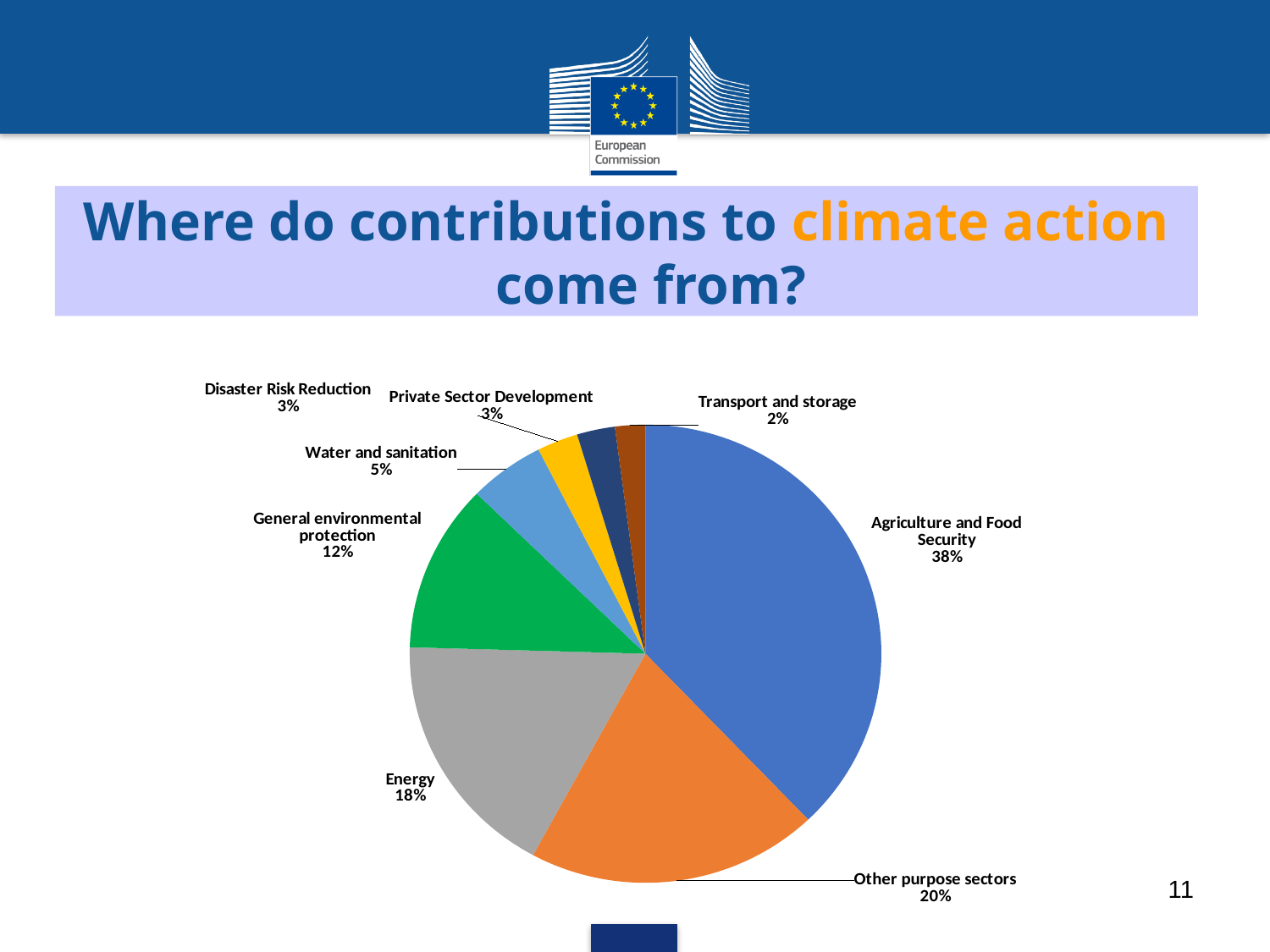
What percentage is shown for Water and sanitation? 5% Which sector has the smallest slice of the pie? Transport and storage What percentage is shown for General environmental protection? 12% What share of contributions to climate action comes from Agriculture and Food Security? 38% How many sectors are shown in the pie chart? 8 Which is larger, the share for Energy or the share for General environmental protection? Energy What type of chart is shown on the slide? Pie chart Which sector has the largest slice of the pie? Agriculture and Food Security What share of the pie does Energy account for? 18% What is the difference in percentage points between Agriculture and Food Security and General environmental protection? 26 What is the difference in percentage points between Other purpose sectors and Energy? 2 What is the title of the slide containing the chart? Where do contributions to climate action come from?